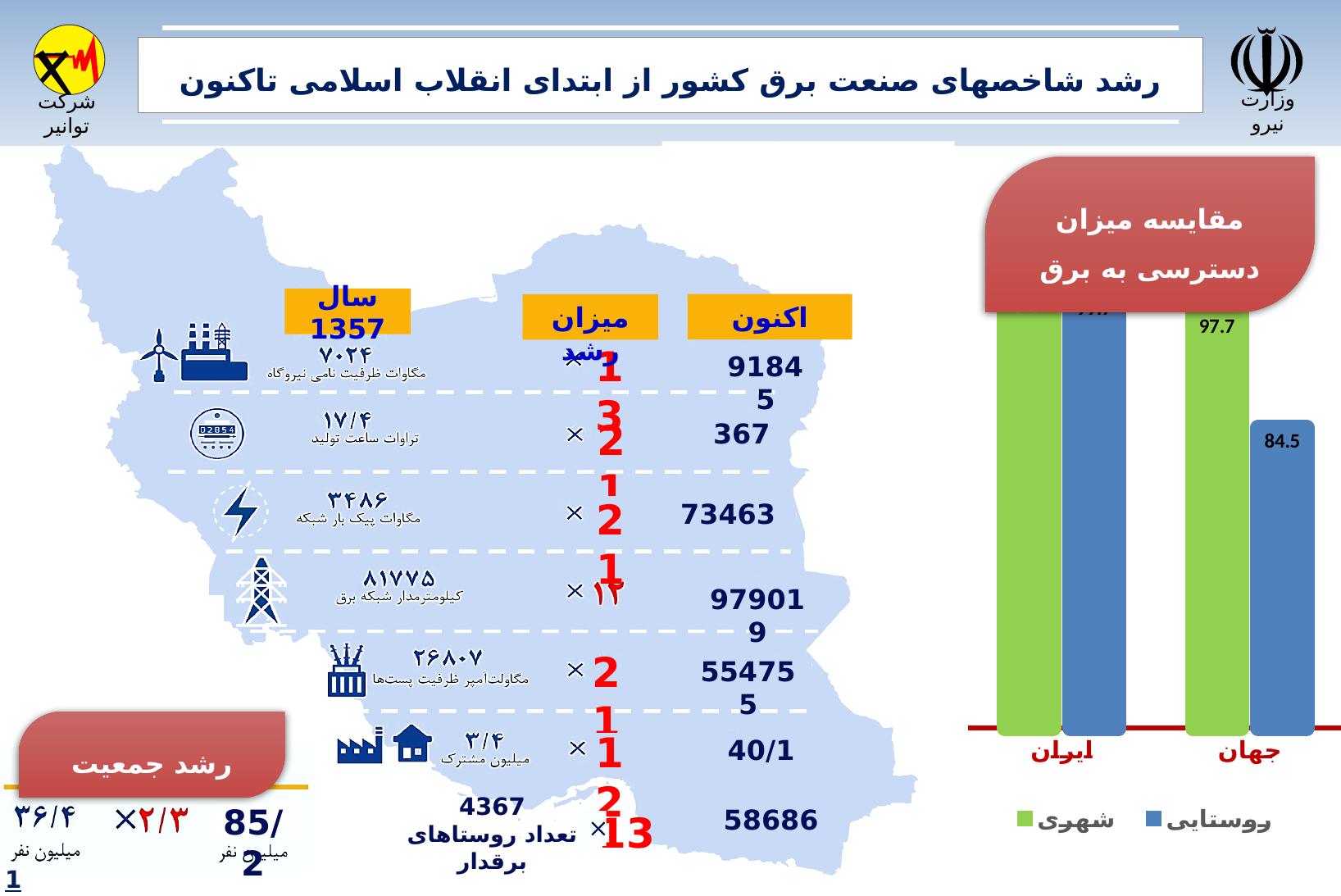
In the chart titled مقایسه میزان دسترسی به برق, which bar is the lowest? روستایی for جهان In the chart titled مقایسه میزان دسترسی به برق, which is larger for جهان: the شهری value or the روستایی value? شهری In the chart titled مقایسه میزان دسترسی به برق, what is the value of the روستایی series for جهان? 84.5 What kind of chart is the chart titled مقایسه میزان دسترسی به برق? Bar chart How many series does the legend of the chart titled مقایسه میزان دسترسی به برق list? 2 In the chart titled مقایسه میزان دسترسی به برق, which is larger: the روستایی value for ایران or the روستایی value for جهان? ایران In the chart titled مقایسه میزان دسترسی به برق, what is the difference between the شهری and روستایی values for جهان? 13.2 In the chart titled مقایسه میزان دسترسی به برق, what is the value of the شهری series for جهان? 97.7 In the chart titled مقایسه میزان دسترسی به برق, which colour represents the روستایی series? Blue What are the two legend entries of the chart titled مقایسه میزان دسترسی به برق? شهری and روستایی How many categories are shown on the x axis of the chart titled مقایسه میزان دسترسی به برق? 2